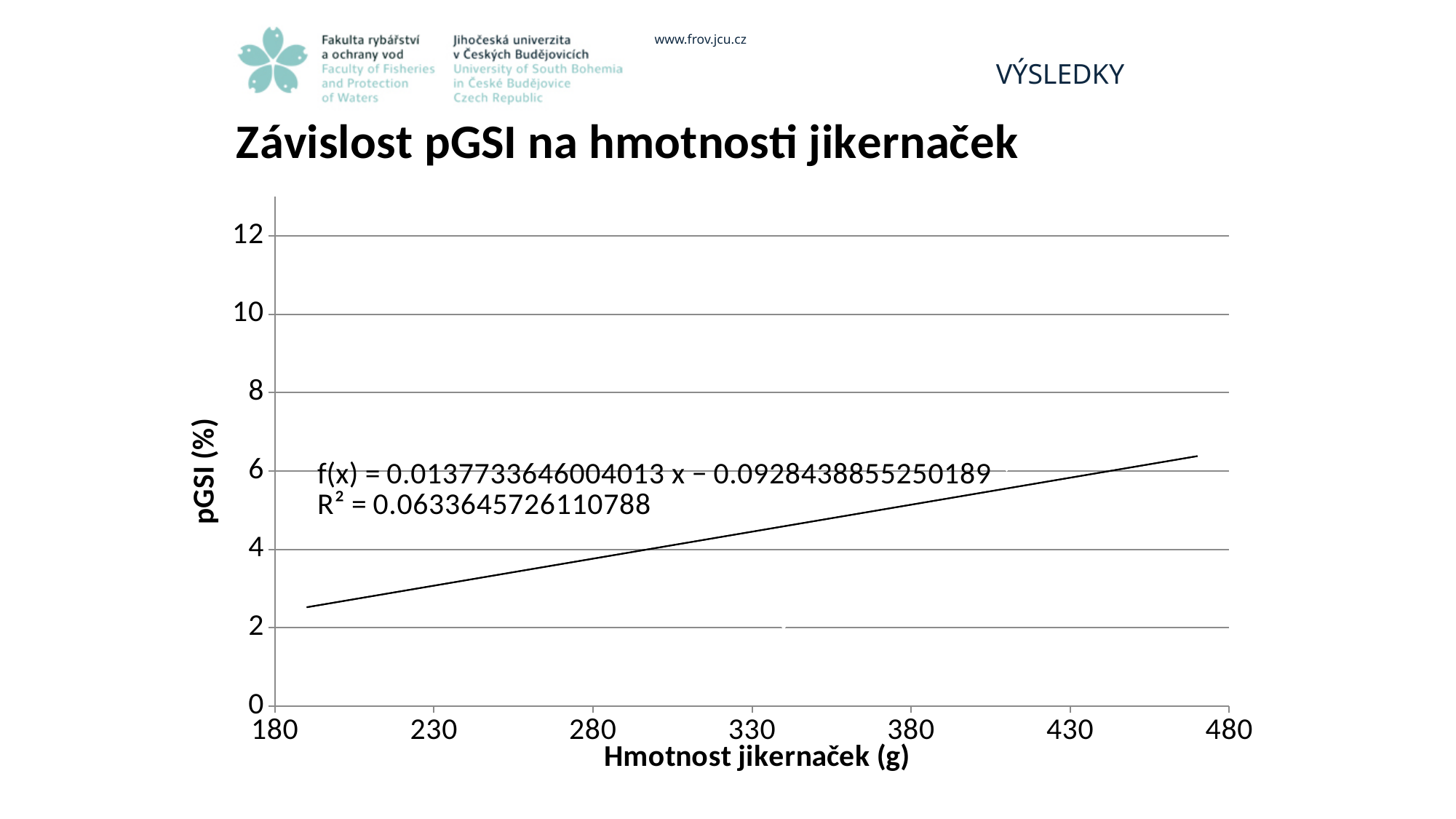
Is the trendline value at a weight of 230 g greater or less than 4? less What is the highest value shown on the y axis? 12 Is the trendline value at a weight of 380 g greater or less than 4? greater What is the spacing between consecutive tick labels on the x axis? 50 Does the trendline rise or fall as the weight (Hmotnost jikernaček) increases? rise Is the trendline value at a weight of 380 g greater or less than 6? less What R² value is printed on the chart? R² = 0.0633645726110788 What is the lowest value shown on the x axis? 180 What is the intercept in the trendline equation printed on the chart? −0.0928438855250189 What is the slope coefficient in the trendline equation printed on the chart? 0.0137733646004013 What is the title of the chart? Závislost pGSI na hmotnosti jikernaček What is the label of the y axis? pGSI (%)